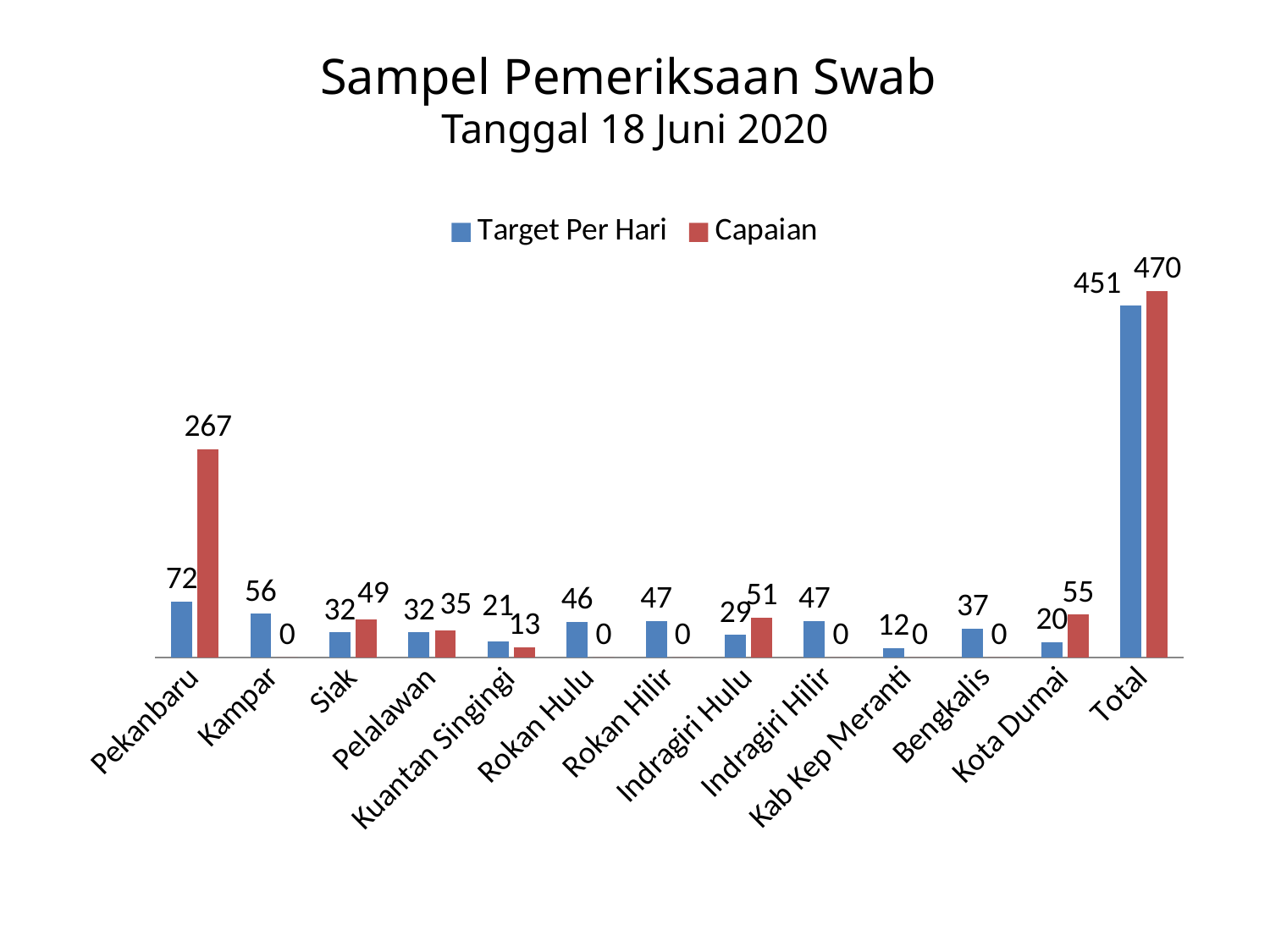
Which is larger for Siak: Target Per Hari or Capaian? Capaian What is the Capaian value for Pekanbaru? 267 What is the Capaian value for Kuantan Singingi? 13 How many categories are shown on the x axis? 13 What kind of chart is shown on the slide? Bar chart Excluding Total, which category has the highest Capaian value? Pekanbaru What is the title of the chart? Sampel Pemeriksaan Swab Tanggal 18 Juni 2020 What is the Target Per Hari value for Kampar? 56 Excluding Total, which category has the lowest Target Per Hari value? Kab Kep Meranti How many series does the legend list? 2 What is the Target Per Hari value for Total? 451 What is the difference between the Capaian and Target Per Hari values for Pekanbaru? 195